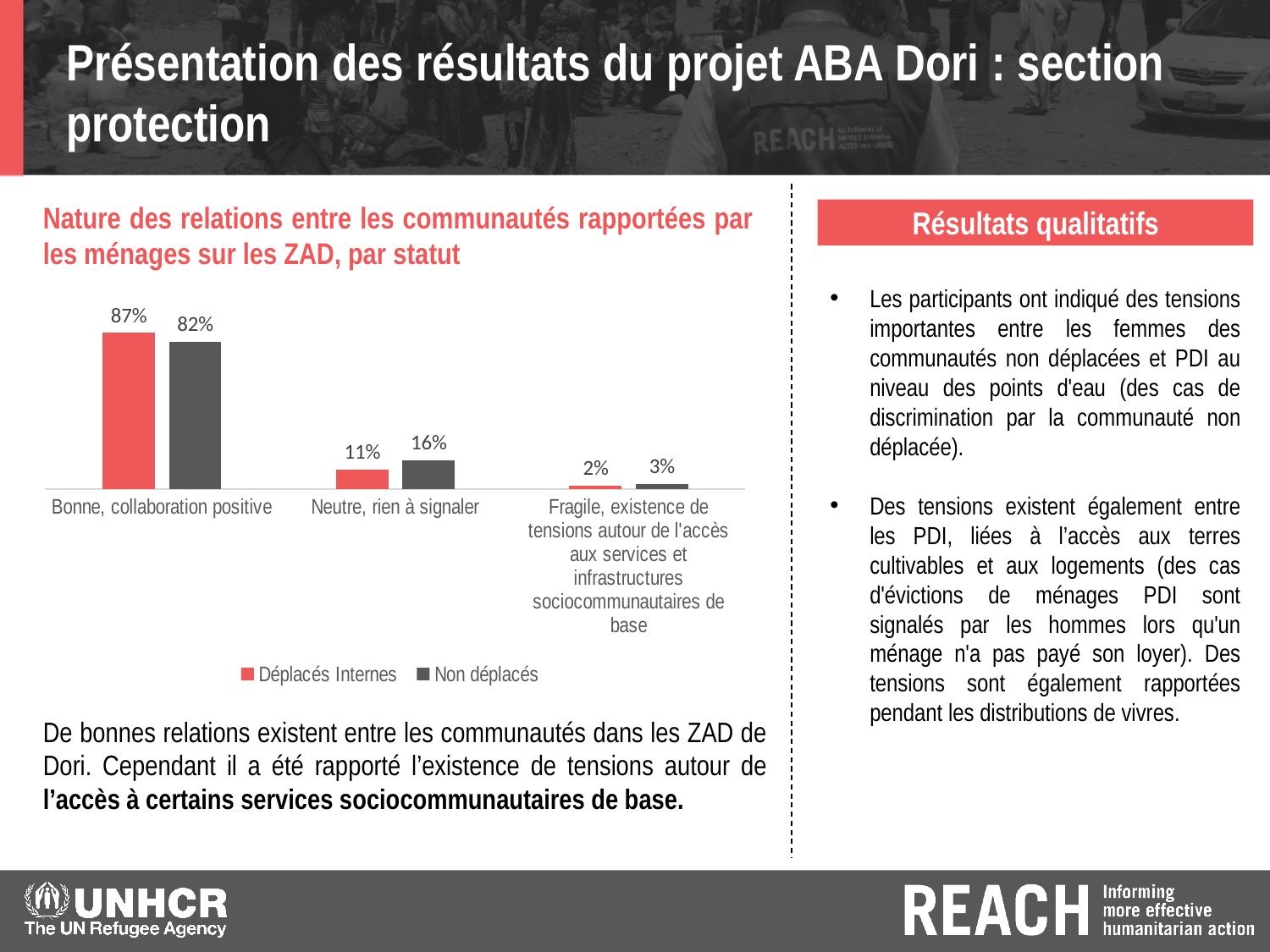
What is the difference between Déplacés Internes and Non déplacés in the 'Bonne, collaboration positive' category? 5% What is the value for Non déplacés in the 'Bonne, collaboration positive' category? 82% What kind of chart is shown on the slide? Bar chart What is the value for Déplacés Internes in the 'Bonne, collaboration positive' category? 87% Which colour represents the Déplacés Internes series in the chart? Red In the 'Neutre, rien à signaler' category, which series has the larger value, Déplacés Internes or Non déplacés? Non déplacés Which category has the lowest value for Non déplacés? Fragile, existence de tensions autour de l'accès aux services et infrastructures sociocommunautaires de base Which category has the highest value for Déplacés Internes? Bonne, collaboration positive How many categories are shown on the x axis of the chart? 3 What is the value for Non déplacés in the 'Neutre, rien à signaler' category? 16% What is the value for Déplacés Internes in the 'Fragile, existence de tensions...' category? 2% How many series does the legend list? 2